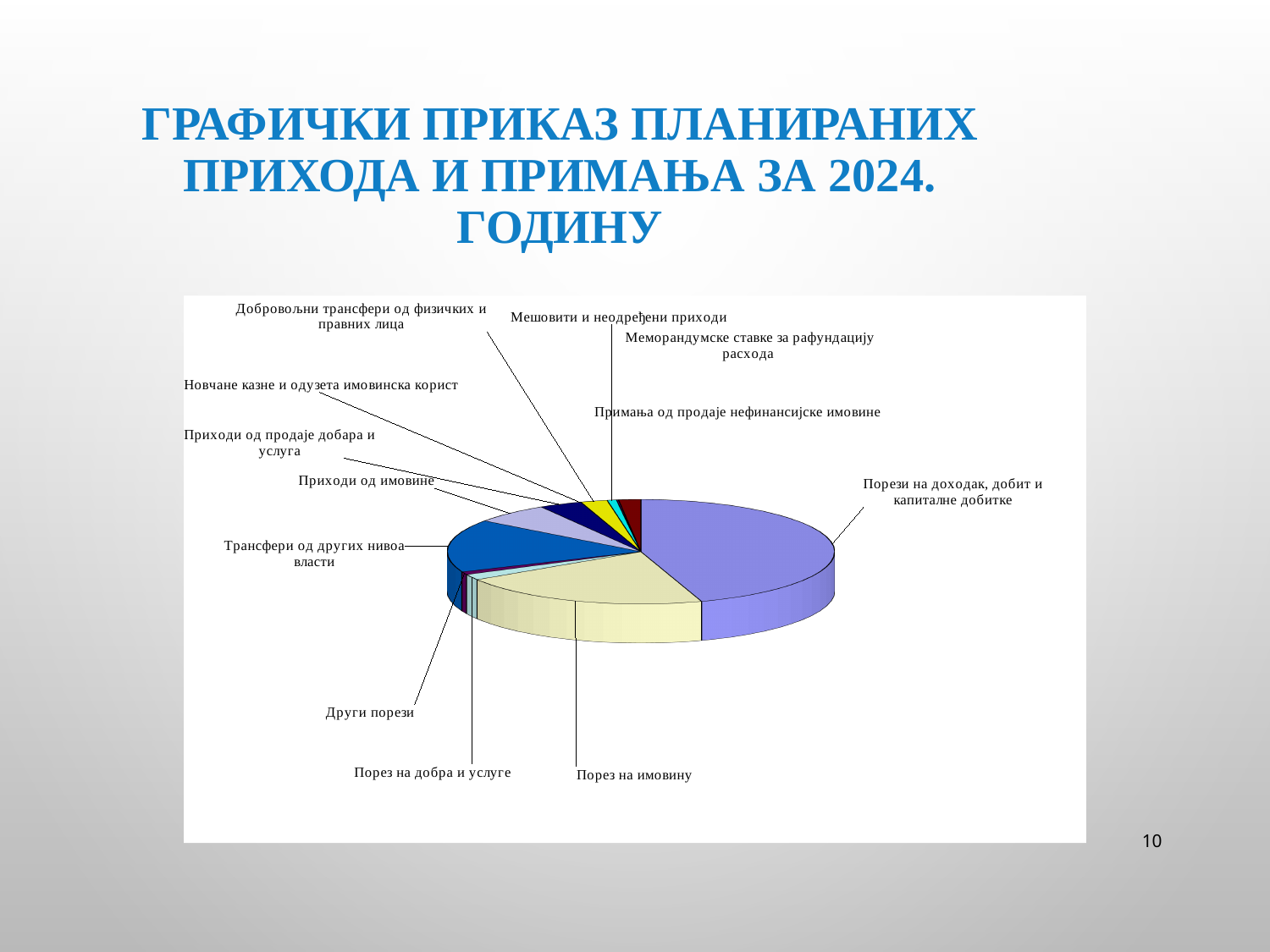
Which slice is larger: Порези на доходак, добит и капиталне добитке or Порез на имовину? Порези на доходак, добит и капиталне добитке Which slice is larger: Порез на имовину or Други порези? Порез на имовину Which slice is larger: Порез на имовину or Трансфери од других нивоа власти? Порез на имовину How many categories (slices) are labelled in the pie chart? 12 What kind of chart is shown on the slide? Pie chart Does the pie chart display numeric data labels on its slices? No Which category is the second-largest slice of the pie chart? Порез на имовину What is the title of the slide containing the pie chart? ГРАФИЧКИ ПРИКАЗ ПЛАНИРАНИХ ПРИХОДА И ПРИМАЊА ЗА 2024. ГОДИНУ Which category has the largest slice of the pie chart? Порези на доходак, добит и капиталне добитке